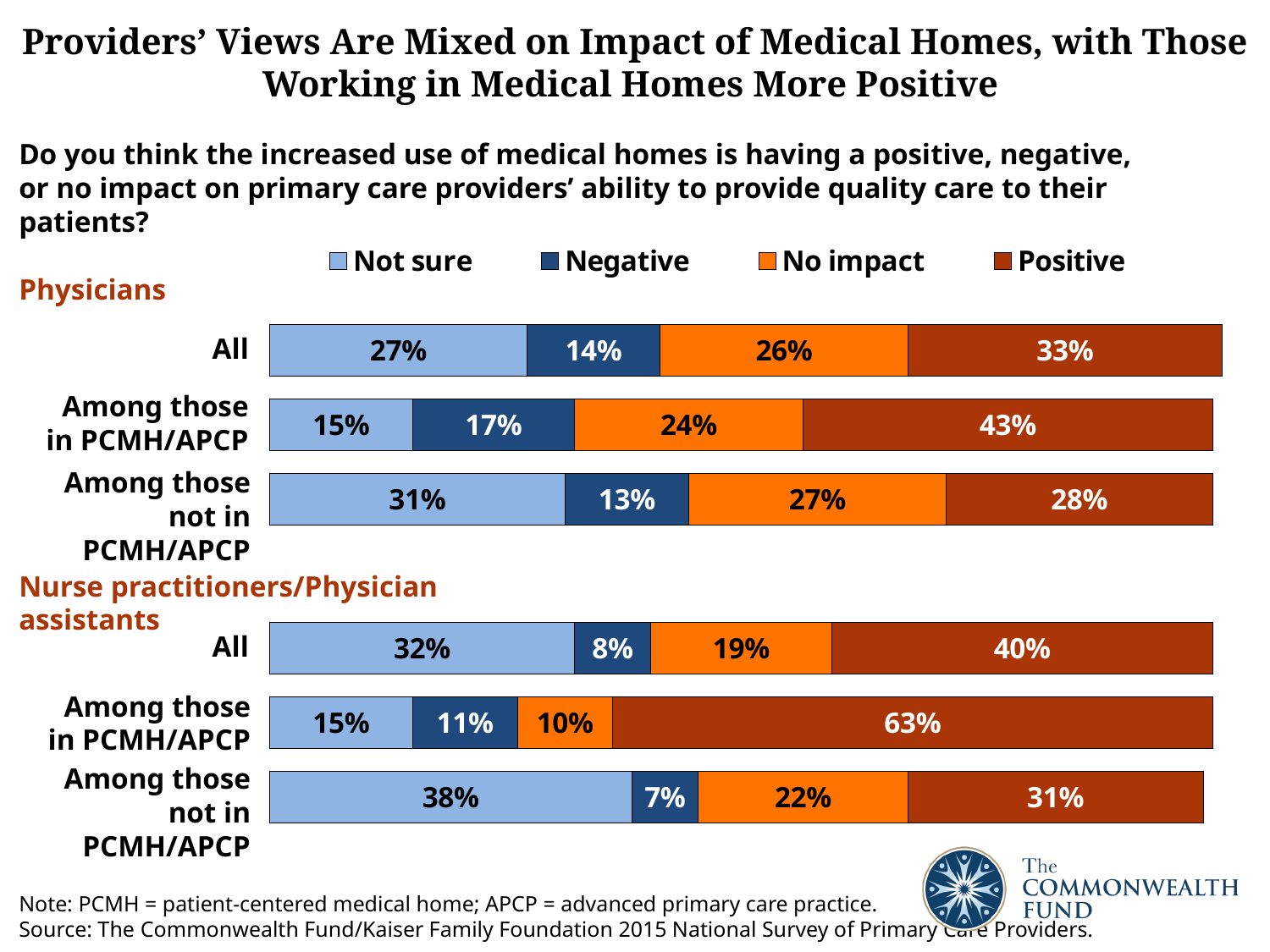
In the Nurse practitioners/Physician assistants chart, which has the larger Not sure share: All or Among those not in PCMH/APCP? Among those not in PCMH/APCP In the Physicians chart, how many percentage points higher is the Positive share for those in PCMH/APCP than for those not in PCMH/APCP? 15 percentage points In the Physicians chart, what is the No impact value for those not in PCMH/APCP? 27% In the Nurse practitioners/Physician assistants chart, which group has the lowest Negative share? Among those not in PCMH/APCP How many series does the legend list? 4 In the Physicians chart, what percentage of all physicians said medical homes have a positive impact? 33% How many bars are shown in the Physicians chart? 3 What type of chart is used on this slide? Stacked bar chart What are the four legend entries shown above the charts? Not sure, Negative, No impact, Positive In the Physicians chart, what is the total of the segments in the All bar? 100% In the Nurse practitioners/Physician assistants chart, what percentage of those in PCMH/APCP said medical homes have a positive impact? 63% In the Physicians chart, which group has the highest Positive share? Among those in PCMH/APCP